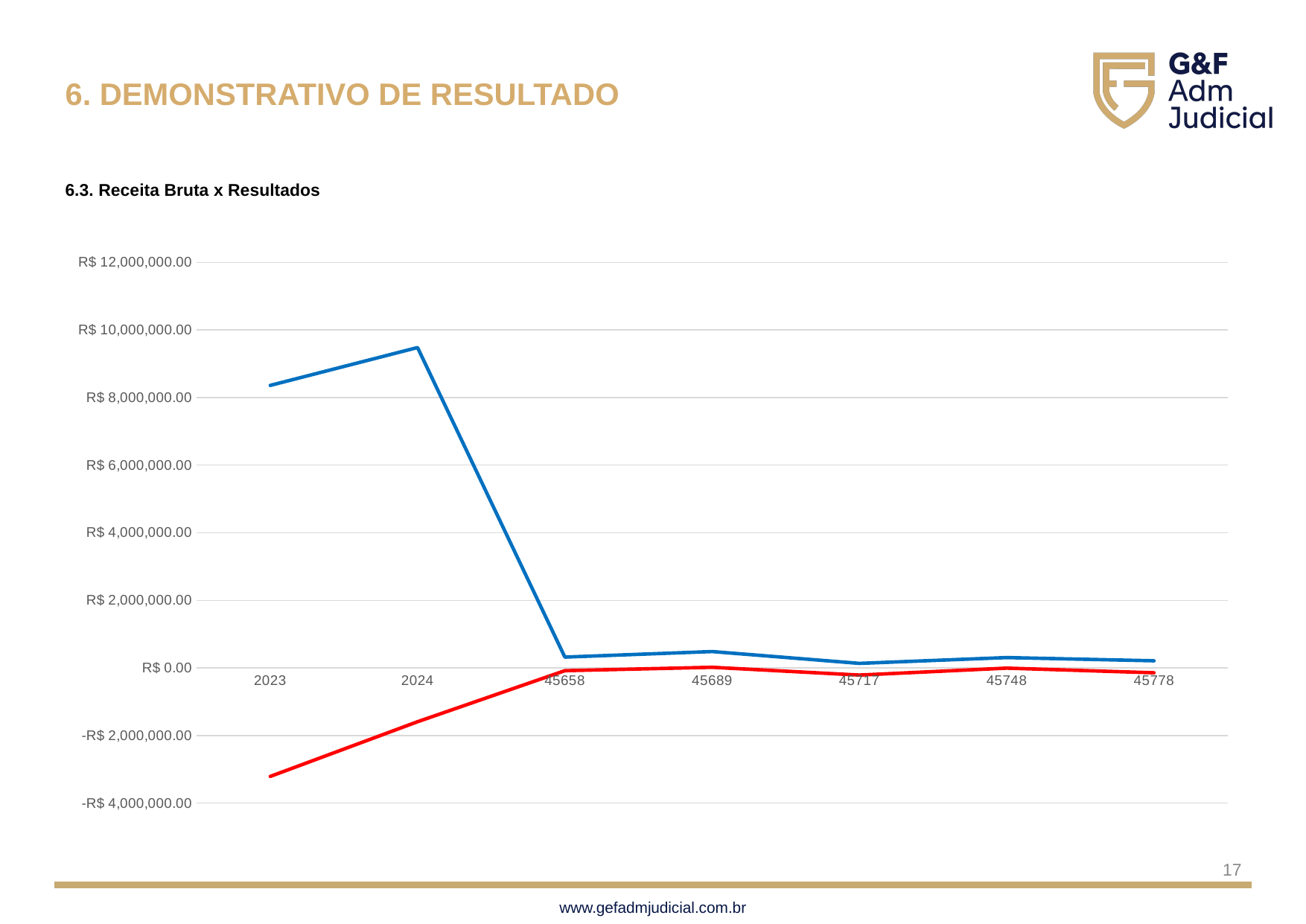
At which x-axis category does the blue line reach its highest value? 2024 How many points are plotted along the x axis of the chart? 7 What is the title of the chart section on the slide? 6.3. Receita Bruta x Resultados Is the value of the blue line at 45658 greater or less than R$ 2,000,000.00? less What kind of chart is shown on the slide? line chart Is the value of the blue line at 2023 greater or less than R$ 10,000,000.00? less Is the value of the blue line at 2024 greater or less than R$ 8,000,000.00? greater Which line has the higher value at 2023, the blue line or the red line? the blue line At which x-axis category does the red line reach its lowest value? 2023 How many lines are plotted on the chart? 2 Does the blue line rise or fall between 2024 and 45658? fall